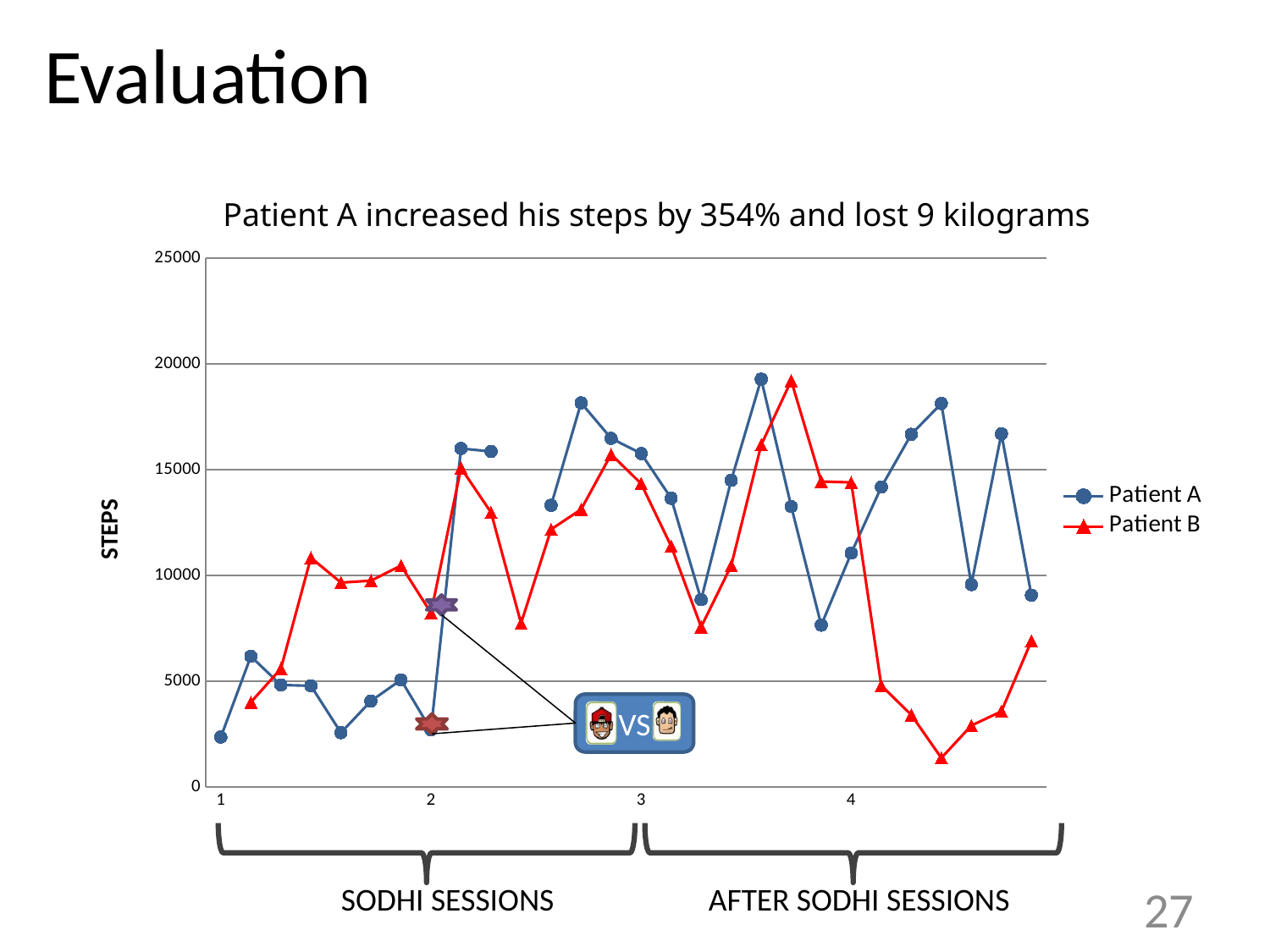
What is the label on the vertical axis? STEPS Is the value for Patient B at x = 2 greater or less than 10000? less Is the value for Patient A at x = 3 greater or less than 15000? greater How many labelled tick marks are on the horizontal axis? 4 Do Patient A's values rise or fall overall from x = 1 to x = 3? rise Is the value for Patient A at x = 4 greater or less than 10000? greater At x = 4, which series has the higher value, Patient A or Patient B? Patient B What kind of chart is shown on the slide? line chart What is the title of the chart? Patient A increased his steps by 354% and lost 9 kilograms How many series does the legend list? 2 At x = 2, which series has the higher value, Patient A or Patient B? Patient B